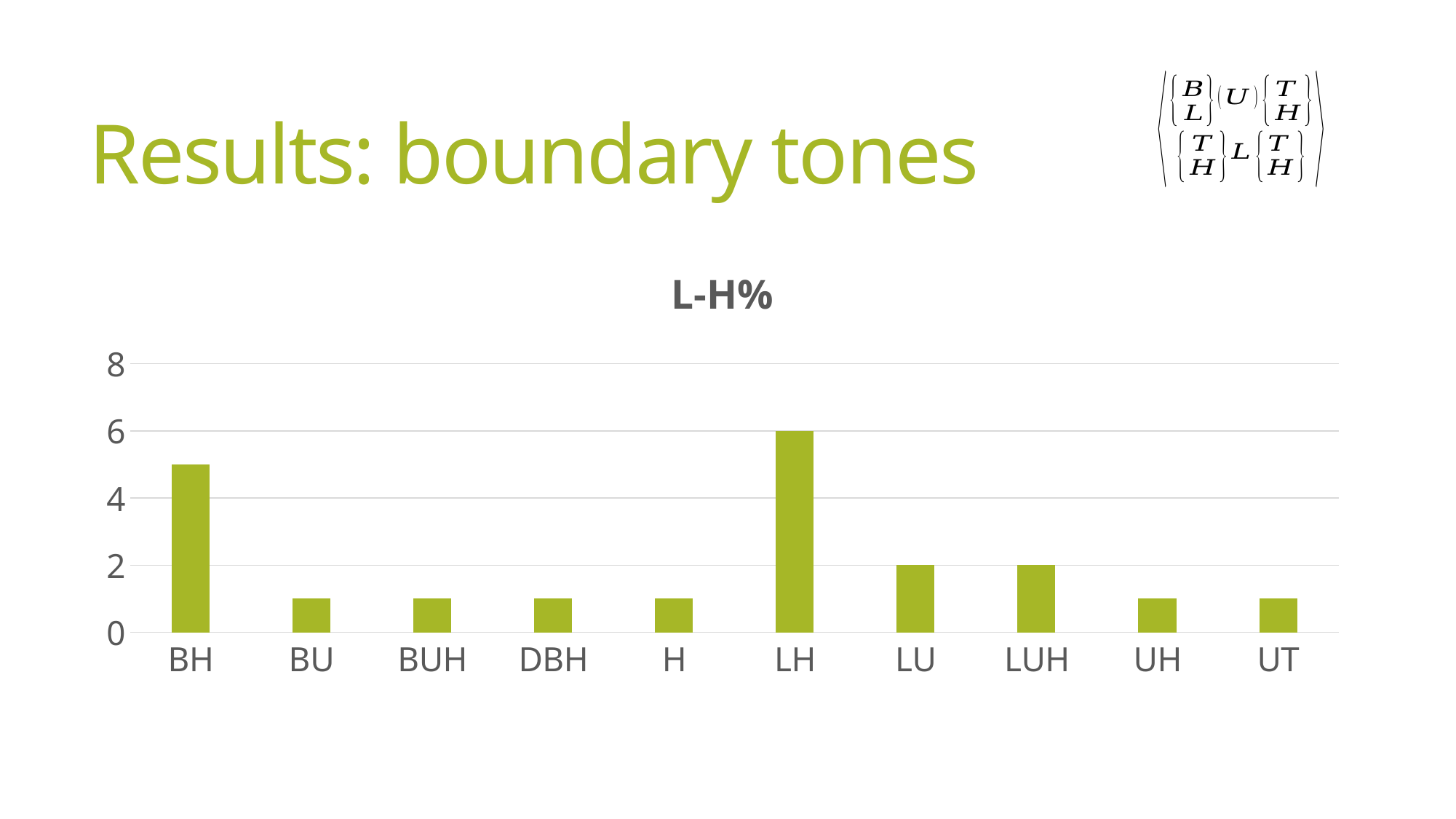
Which is larger, the value for BH or the value for LUH? BH What is the difference between the values for LH and LU? 4 How many categories are shown on the x axis of the chart? 10 What is the value for LU? 2 What is the title of the chart? L-H% What is the value for LH? 6 What kind of chart is shown on the slide? bar chart Is the value for BU greater or less than 2? less Which category has the highest value in the chart? LH What is the value for LUH? 2 Is the value for BH greater or less than 4? greater Which is larger, the value for BH or the value for LH? LH